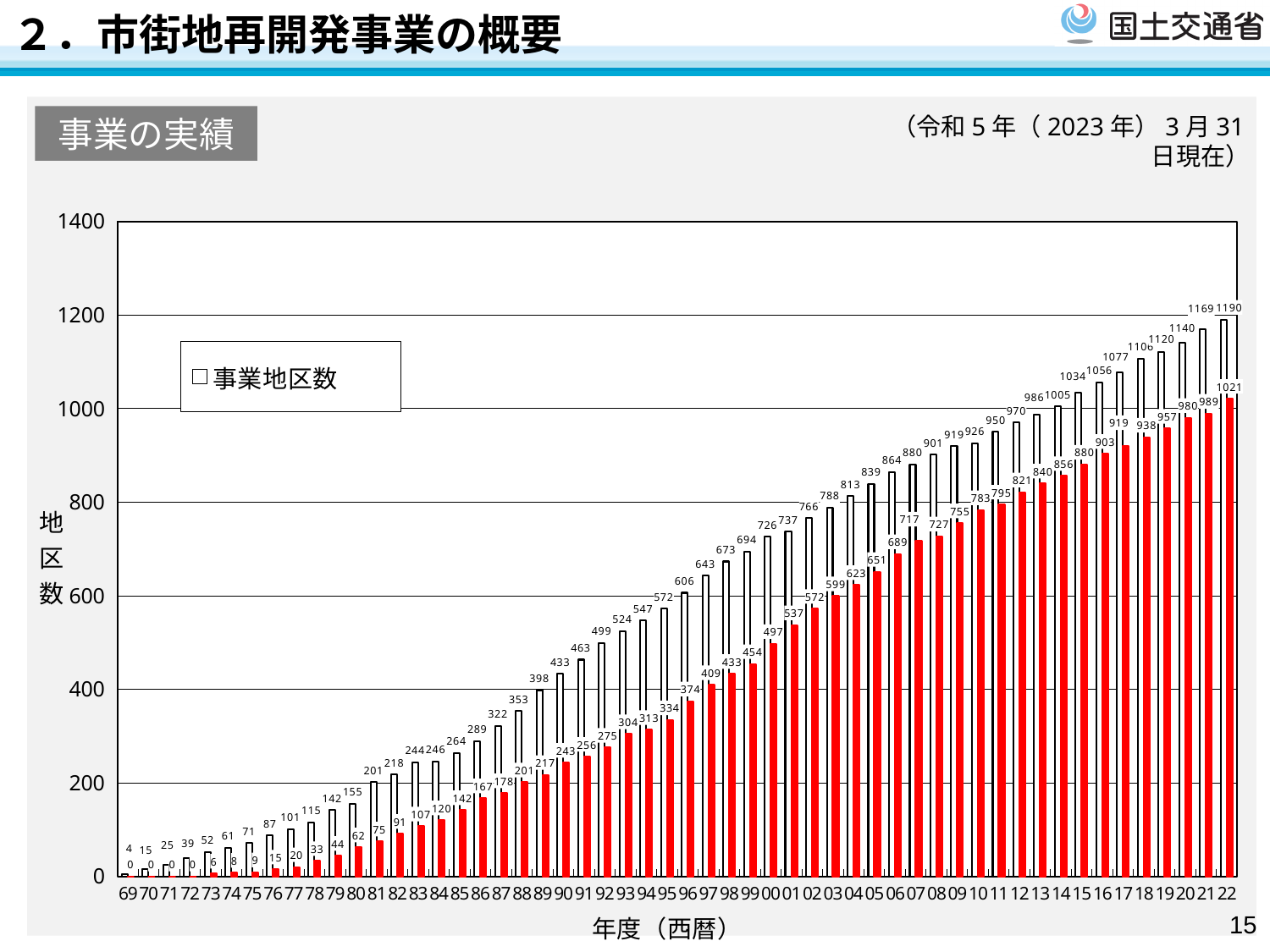
Which is larger, the white bar (事業地区数) for year 10 or for year 05? year 10 What type of chart is shown on the slide? bar chart What is the value of the white bar (事業地区数) for year 22? 1190 What is the value of the white bar (事業地区数) for year 00? 726 How many series does the legend list? 1 Which year has the lowest value for 事業地区数 (white bars)? 69 Which year has the highest value for 事業地区数 (white bars)? 22 What is the value of the red bar for year 22? 1021 What is the difference between the white bar and the red bar for year 22? 169 What is the label on the x axis of the chart? 年度（西暦） What is the value of the red bar for year 90? 243 Do the values of 事業地区数 rise or fall from year 69 to year 22? rise